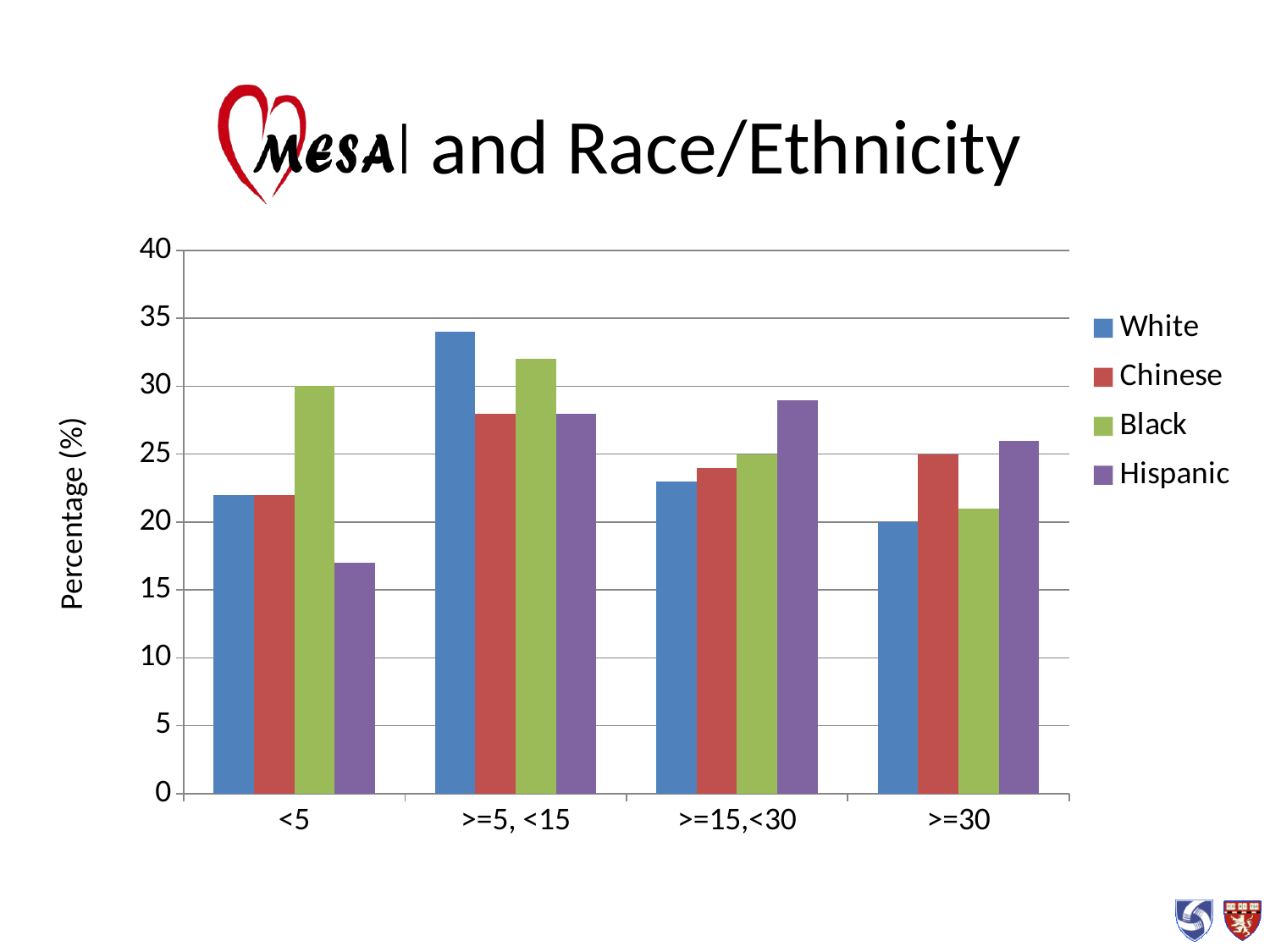
How many series does the legend list? 4 What kind of chart is shown on the slide? bar chart What is the label of the vertical axis? Percentage (%) Which series has the highest value in the >=5, <15 category? White Which series has the lowest value in the <5 category? Hispanic Is the value for Hispanic in the <5 category greater or less than 20? less Which is larger in the >=30 category, the value for Chinese or the value for Black? Chinese What is the value for Black in the <5 category? 30 Is the value for Hispanic in the >=15,<30 category greater or less than 25? greater Which series has the highest value in the <5 category? Black Is the value for White in the >=5, <15 category greater or less than 30? greater How many categories are shown on the x axis? 4